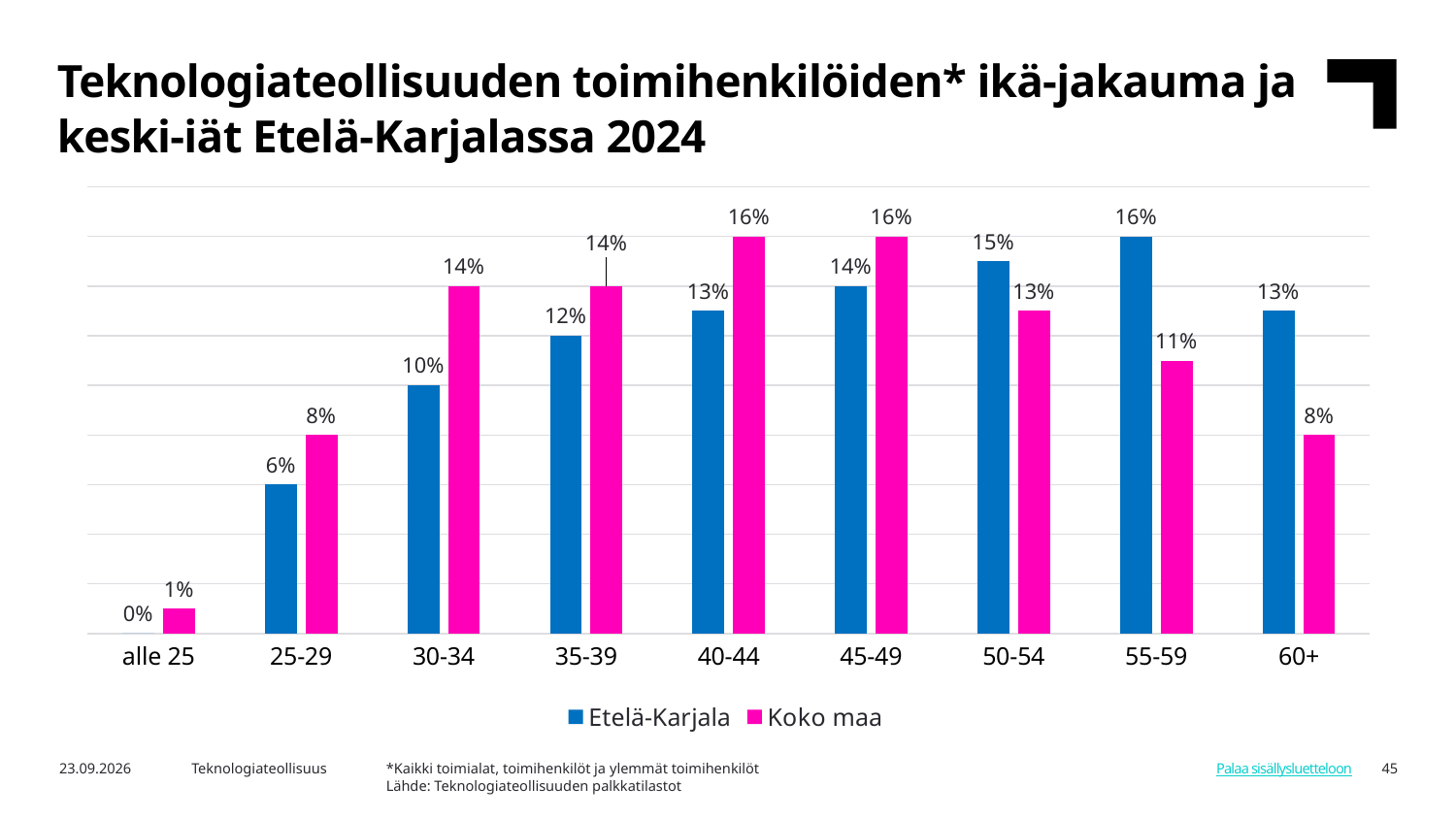
Which age group has the highest value for Etelä-Karjala? 55-59 How many age categories are shown on the x axis? 9 What is the value for Etelä-Karjala in the 55-59 age group? 16% Which series is shown in pink in the legend? Koko maa In the 55-59 age group, which series has the larger value, Etelä-Karjala or Koko maa? Etelä-Karjala What is the difference between Koko maa and Etelä-Karjala in the 30-34 age group? 4% What is the value for Etelä-Karjala in the 25-29 age group? 6% Do the Etelä-Karjala values rise or fall from the alle 25 group to the 55-59 group? Rise How many series does the legend list? 2 Which age group has the lowest value for Koko maa? alle 25 What kind of chart is shown on the slide? Bar chart What is the value for Koko maa in the 30-34 age group? 14%